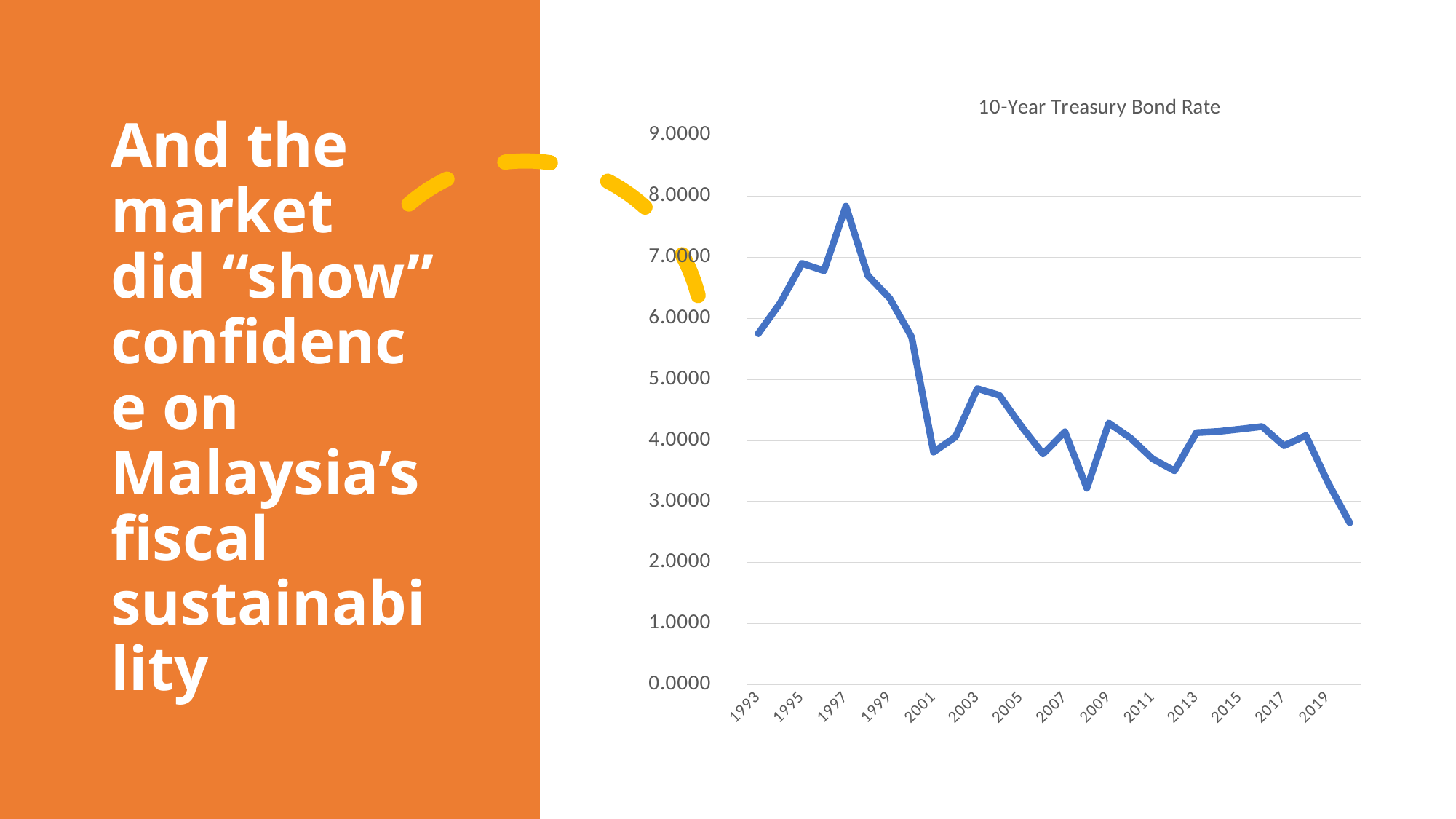
How many year labels are shown on the x axis of the chart? 14 Which year has the higher 10-Year Treasury Bond Rate, 1993 or 2001? 1993 What is the title of the chart? 10-Year Treasury Bond Rate Overall, does the 10-Year Treasury Bond Rate rise or fall from 1993 to the end of the series? fall Is the 10-Year Treasury Bond Rate for 1993 greater or less than 5.0000? greater What kind of chart is shown on the slide? line chart Which year has the higher 10-Year Treasury Bond Rate, 1997 or 2009? 1997 Is the 10-Year Treasury Bond Rate for 1997 greater or less than 7.0000? greater Which labelled year has the highest 10-Year Treasury Bond Rate? 1997 Is the 10-Year Treasury Bond Rate for 2009 greater or less than 4.0000? greater